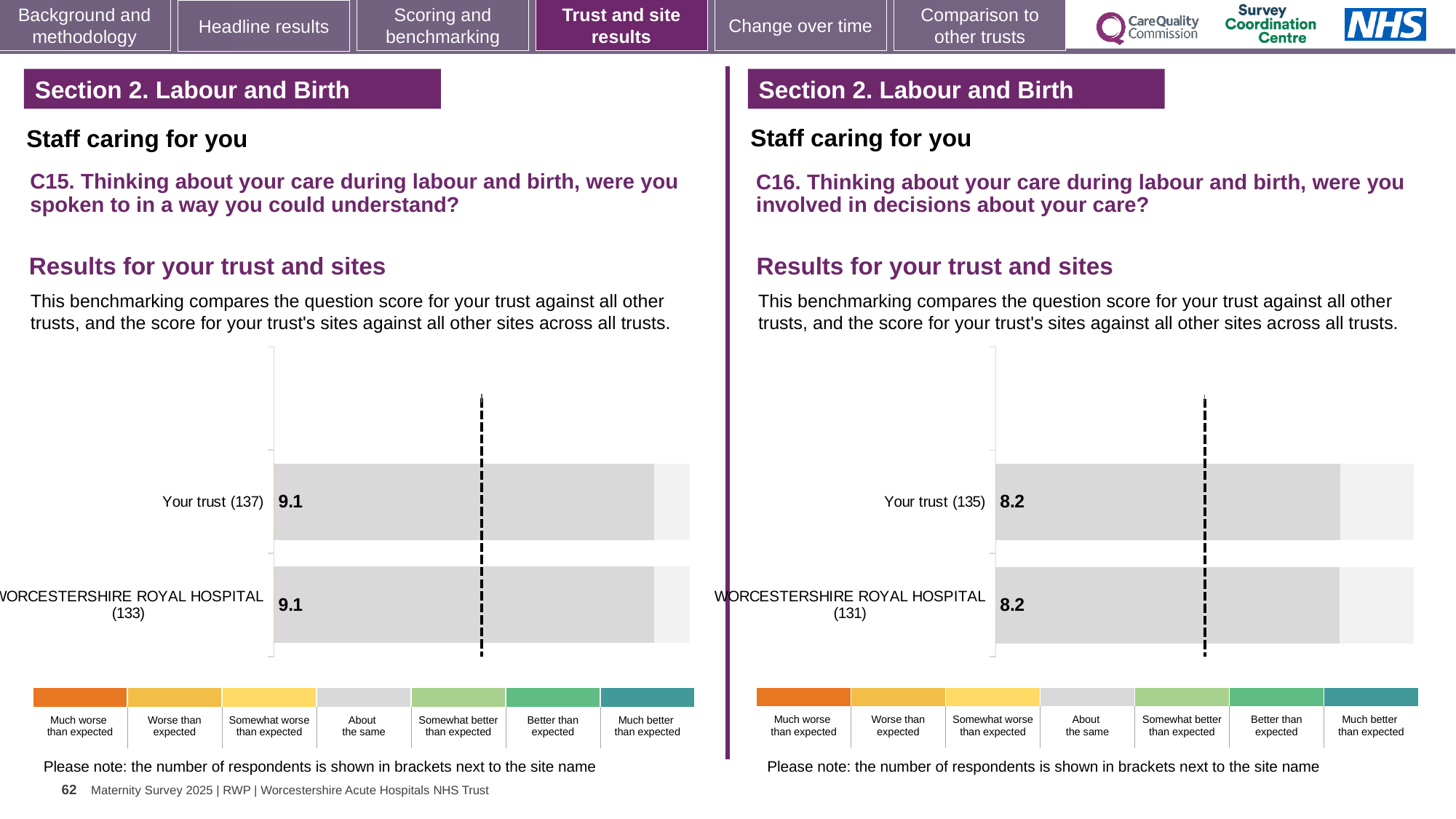
On the C15 chart (left), how many respondents are shown in brackets for Your trust? 137 On the C16 chart (right), what is the score for Worcestershire Royal Hospital? 8.2 Is the score for Your trust on the C15 chart (left) larger or smaller than the score for Your trust on the C16 chart (right)? Larger On the C15 chart (left), what is the difference between the score for Your trust and the score for Worcestershire Royal Hospital? 0.0 On the C15 chart (left), what is the score for Your trust? 9.1 How many bars are plotted on the C16 chart (right)? 2 What kind of chart is used on the C15 chart (left)? Bar chart On the C16 chart (right), what is the score for Your trust? 8.2 On the C16 chart (right), what is the difference between the score for Your trust and the score for Worcestershire Royal Hospital? 0.0 On the C16 chart (right), how many respondents are shown in brackets for Worcestershire Royal Hospital? 131 How many bars are plotted on the C15 chart (left)? 2 On the C15 chart (left), what is the score for Worcestershire Royal Hospital? 9.1